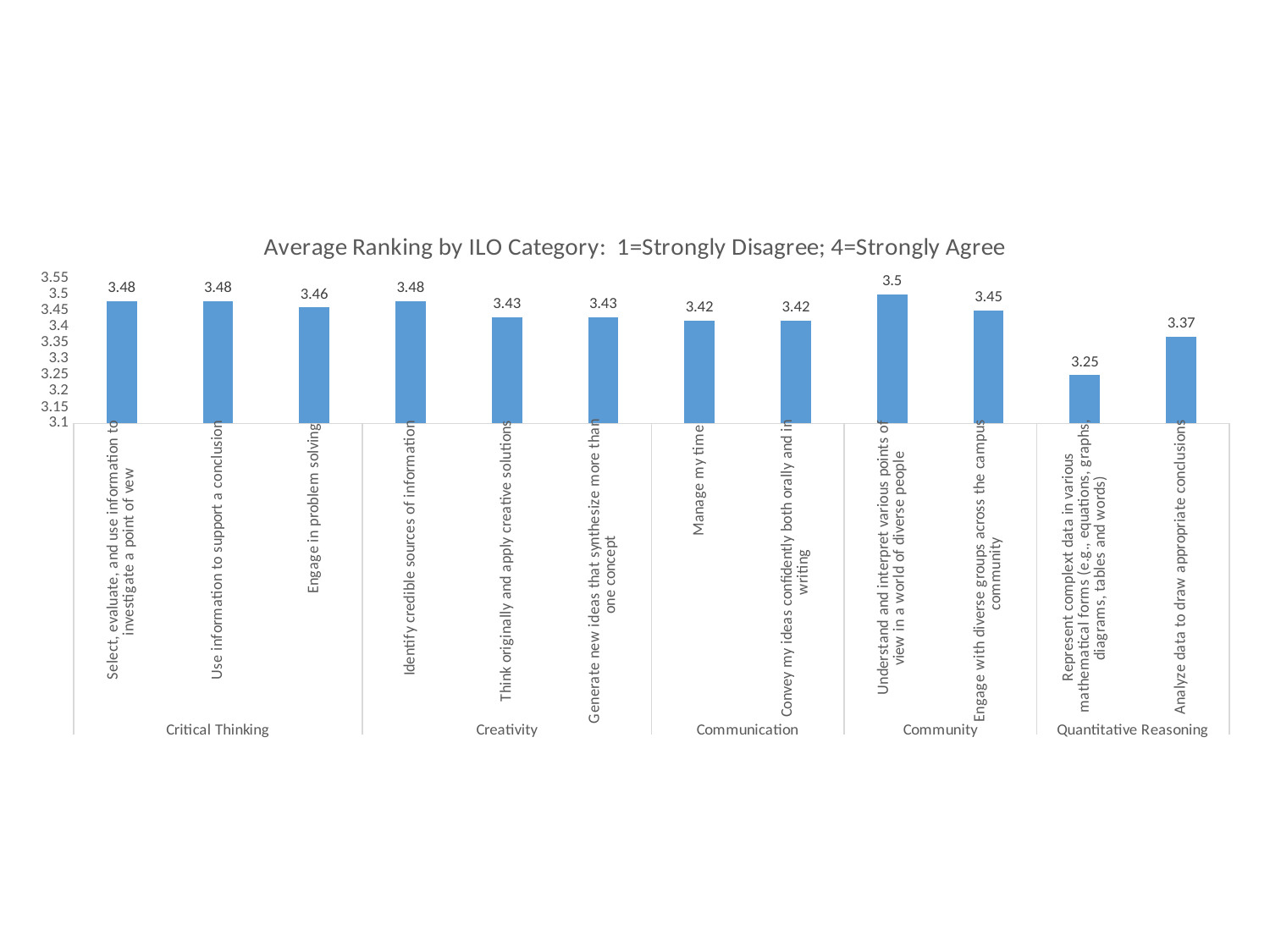
How many ILO category groups are shown along the x axis? 5 Which item has the lowest average ranking? Represent complext data in various mathematical forms (e.g., equations, graphs diagrams, tables and words) How many bars are plotted in the chart? 12 Which item has the highest average ranking? Understand and interpret various points of view in a world of diverse people What is the average ranking for "Analyze data to draw appropriate conclusions"? 3.37 What is the average ranking for "Manage my time"? 3.42 What is the average ranking for "Engage in problem solving"? 3.46 What is the difference between the highest average ranking (3.5) and the lowest (3.25)? 0.25 What type of chart is shown on the slide? Bar chart What is the average ranking for "Engage with diverse groups across the campus community"? 3.45 Which has a higher average ranking: "Engage in problem solving" or "Think originally and apply creative solutions"? Engage in problem solving What is the title of the chart? Average Ranking by ILO Category: 1=Strongly Disagree; 4=Strongly Agree